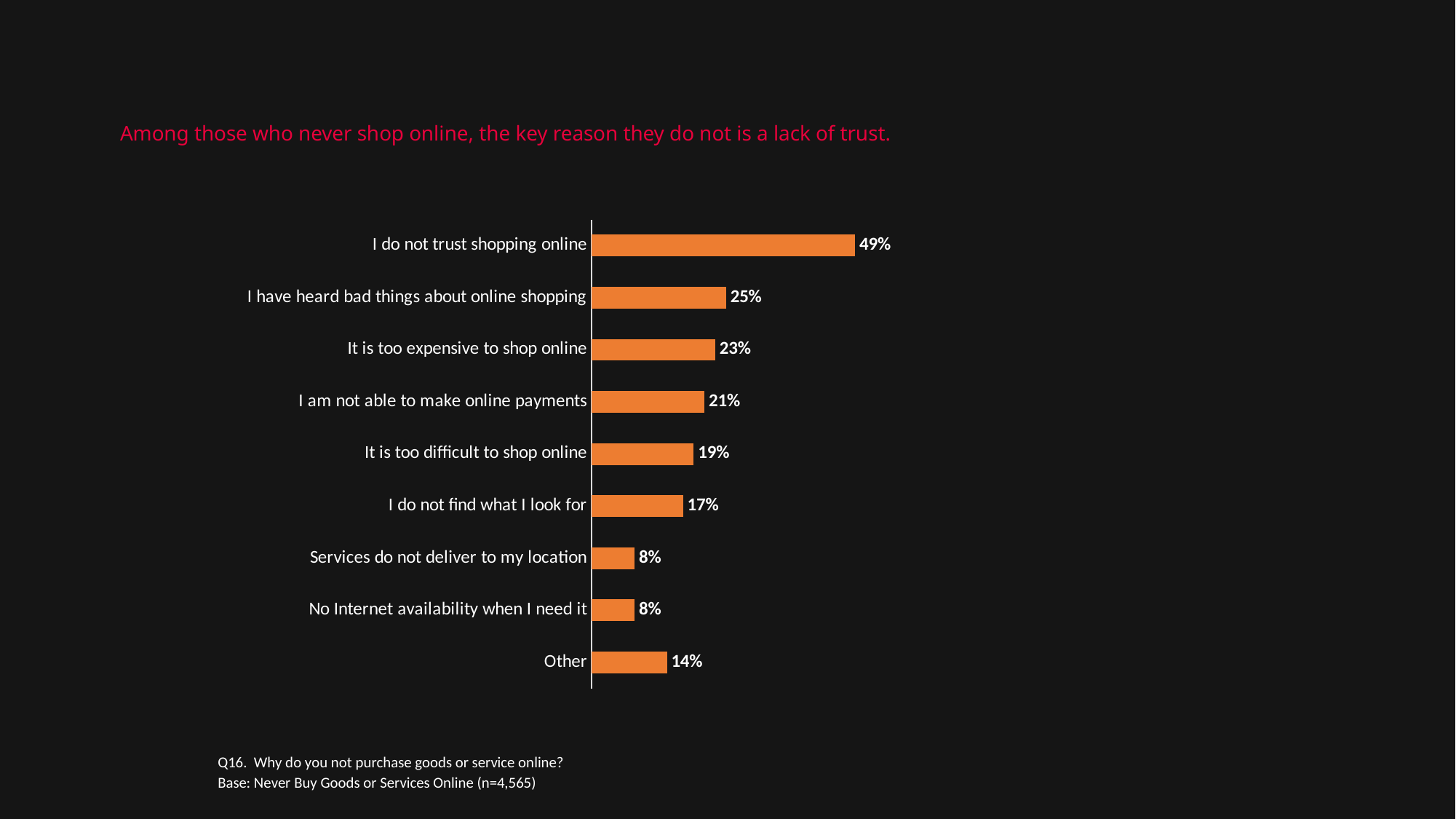
What is the base sample size (n) stated below the chart? n=4,565 How many reasons (categories) are shown in the chart? 9 What is the value for "Services do not deliver to my location"? 8% What colour are the bars in the chart? Orange Which is larger: "I am not able to make online payments" or "It is too difficult to shop online"? I am not able to make online payments Which reason has the highest value? I do not trust shopping online What is the value for "Other"? 14% What percentage of respondents said "I do not trust shopping online"? 49% What is the difference between "I do not trust shopping online" and "I have heard bad things about online shopping"? 24 percentage points What is the difference between "I do not find what I look for" and "No Internet availability when I need it"? 9 percentage points What kind of chart is shown on the slide? Bar chart What is the value for "It is too expensive to shop online"? 23%